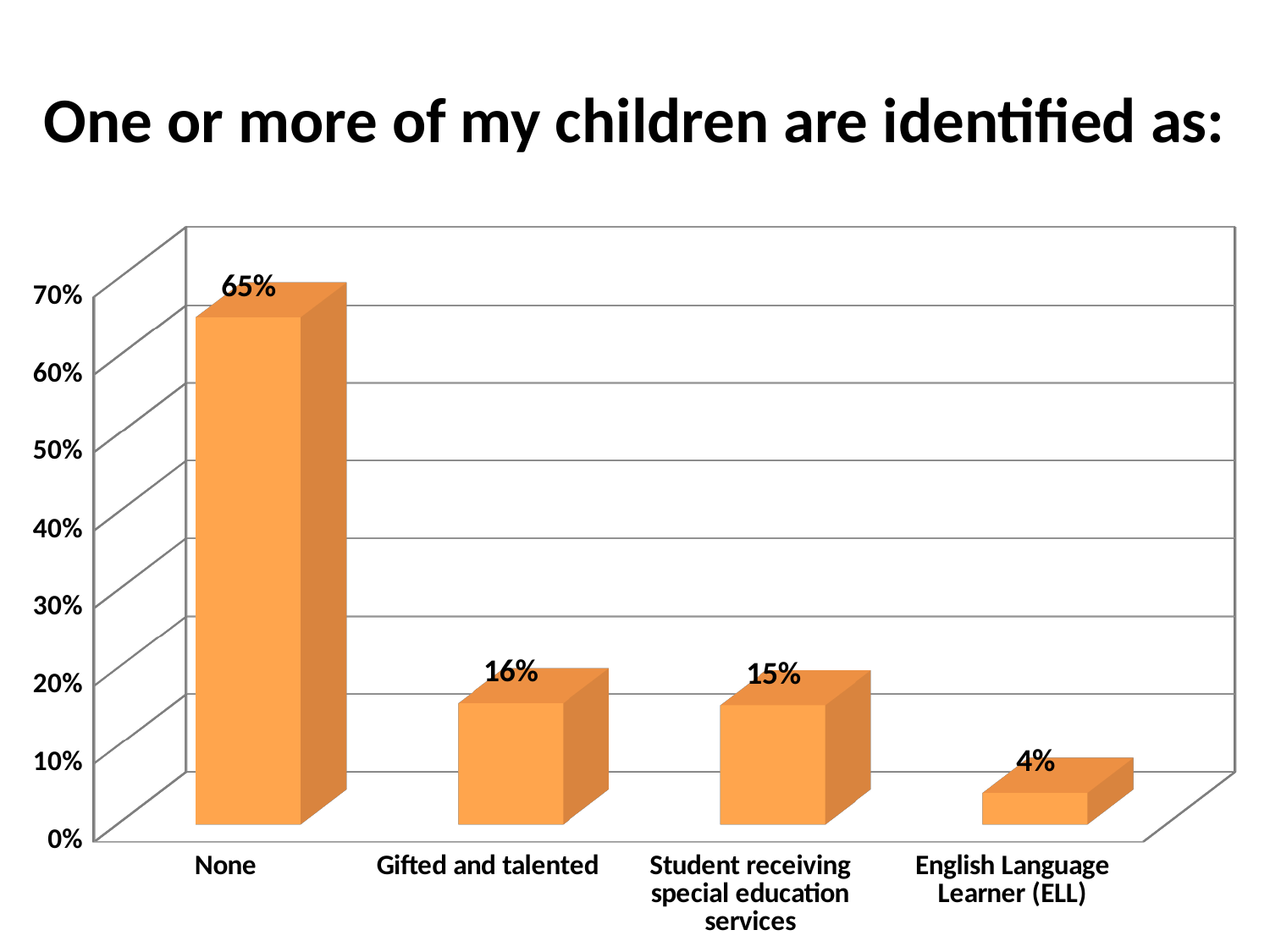
How many categories are shown on the chart? 4 What is the value for "Student receiving special education services"? 15% What kind of chart is shown on the slide? Bar chart Which category has the highest value? None What percentage of respondents selected "None"? 65% What is the difference between the values for "None" and "Gifted and talented"? 49% What is the title of the chart? One or more of my children are identified as: Which is larger: the value for "Gifted and talented" or the value for "English Language Learner (ELL)"? Gifted and talented What is the value for "English Language Learner (ELL)"? 4% Which category has the lowest value? English Language Learner (ELL) What is the difference between the values for "Student receiving special education services" and "English Language Learner (ELL)"? 11% What is the value for "Gifted and talented"? 16%